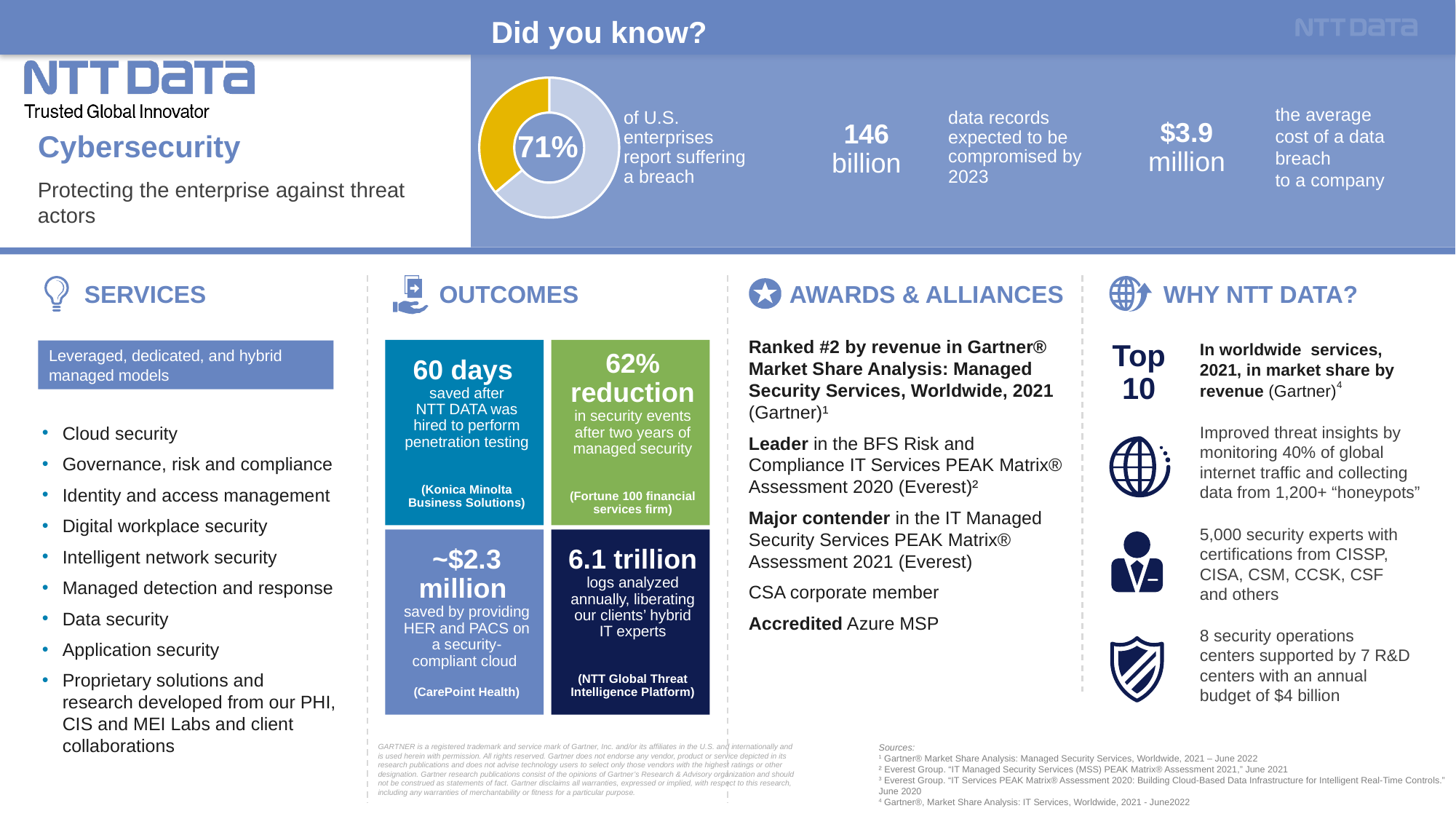
Is the value shown in the donut chart greater or less than 50%? Greater How many segments does the donut chart have? 2 What percentage is printed in the center of the donut chart? 71% What kind of chart is shown in the "Did you know?" banner at the top of the slide? A donut (pie) chart Is the highlighted segment of the donut chart larger or smaller than the remaining segment? Smaller What does the 71% in the donut chart describe? U.S. enterprises that report suffering a breach According to the donut chart, what share of U.S. enterprises report suffering a breach? 71%